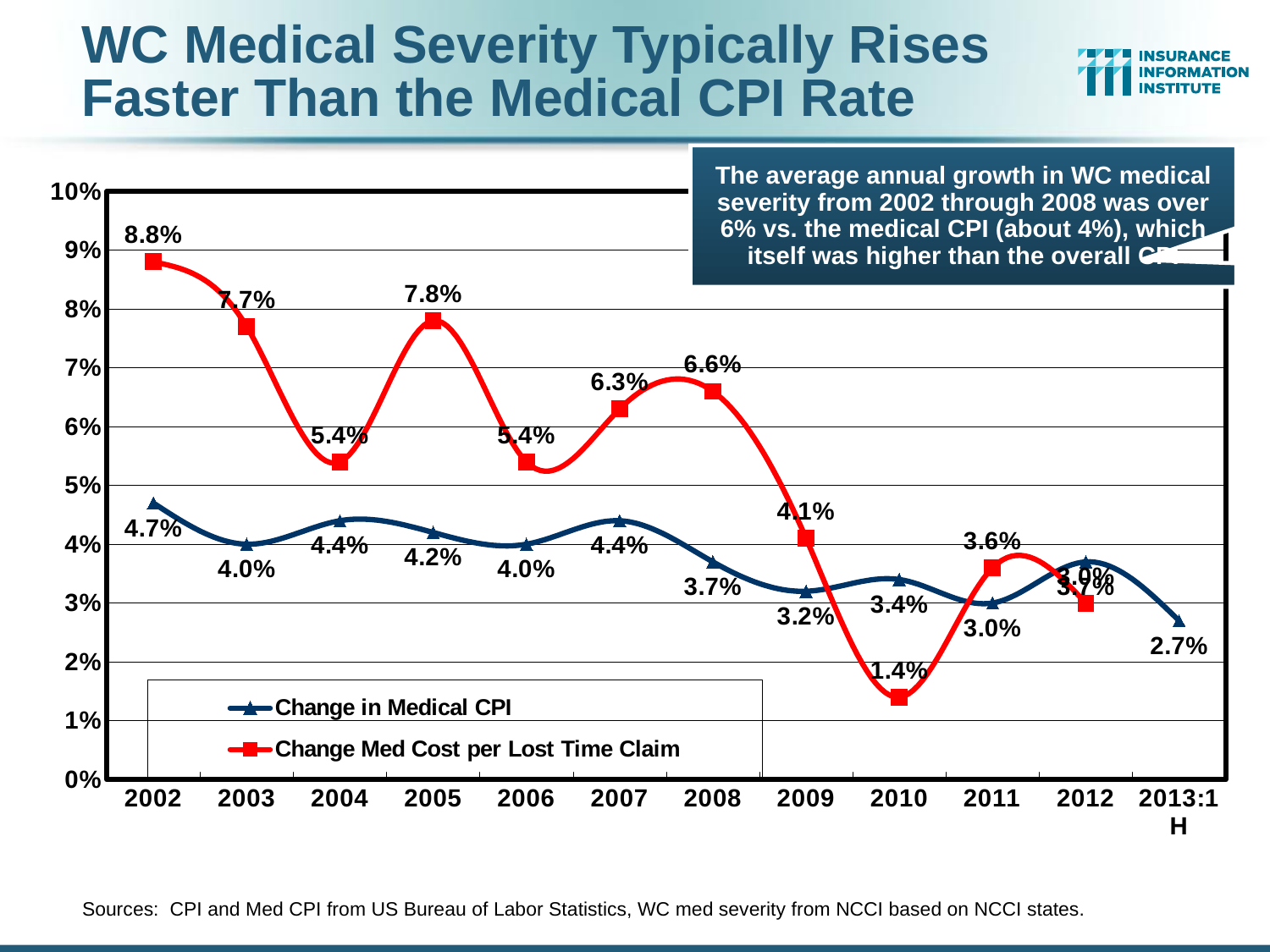
What is the Change Med Cost per Lost Time Claim value for 2005? 7.8% In 2010, which series has the larger value, Change in Medical CPI or Change Med Cost per Lost Time Claim? Change in Medical CPI In which year is the Change Med Cost per Lost Time Claim highest? 2002 How many series does the legend list? 2 What is the Change in Medical CPI value for 2010? 3.4% What is the Change Med Cost per Lost Time Claim value for 2002? 8.8% In 2002, how much higher is the Change Med Cost per Lost Time Claim than the Change in Medical CPI? 4.1% Which colour is used for the Change Med Cost per Lost Time Claim line? Red How many time periods are shown on the x axis? 12 What is the Change in Medical CPI value for 2013:1H? 2.7% What kind of chart is shown on the slide? Line chart In which year is the Change Med Cost per Lost Time Claim lowest? 2010